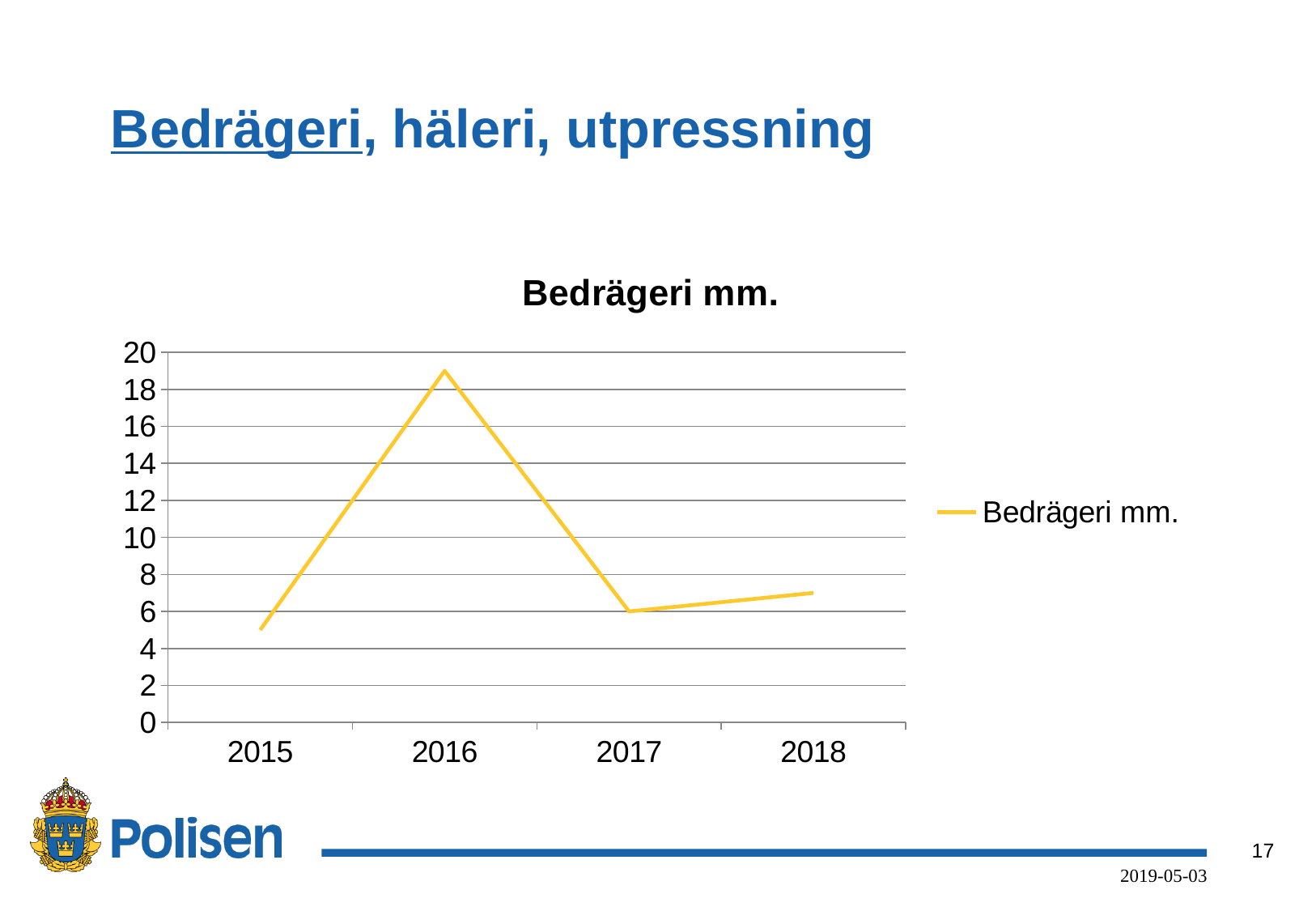
Does the value rise or fall from 2016 to 2017? fall How many years are plotted on the x axis? 4 What is the title of the chart? Bedrägeri mm. Is the value for 2018 greater or less than 6? greater What is the value for Bedrägeri mm. in 2017? 6 Which year has the highest value for Bedrägeri mm.? 2016 Is the value for 2016 greater or less than 18? greater What kind of chart is shown on the slide? line chart Is the value for 2015 greater or less than 6? less Which is larger, the value for 2016 or the value for 2017? 2016 Which year has the lowest value for Bedrägeri mm.? 2015 How many series does the legend list? 1